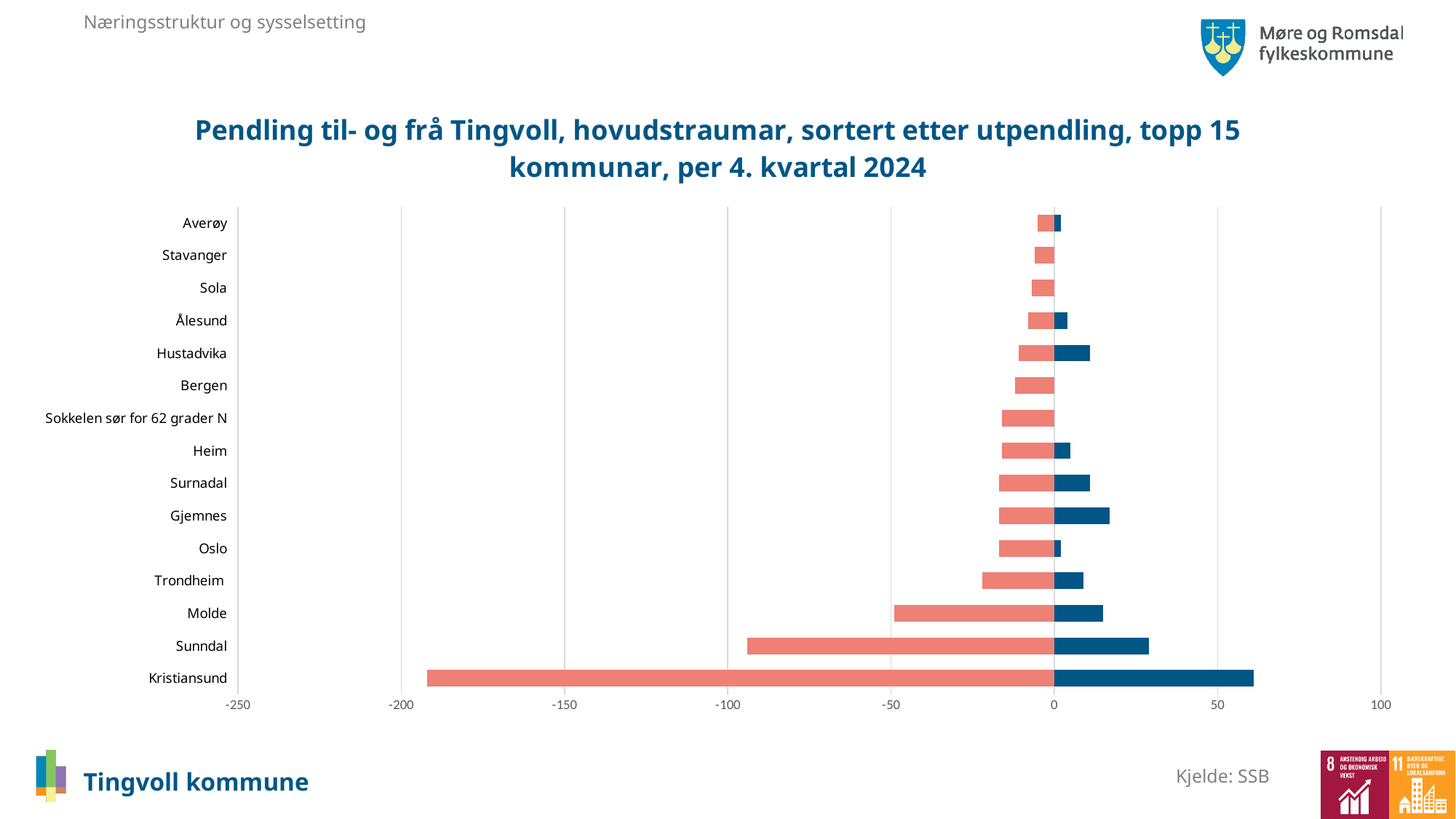
Is the red bar value for Sunndal greater or less than -50? less Is the red bar value for Kristiansund greater or less than -150? less What kind of chart is shown on the slide? bar chart What is the lowest value shown on the horizontal axis of the chart? -250 Is the blue bar value for Kristiansund greater or less than 50? greater What source is cited for the chart data on the slide? SSB Which has the longer blue bar, Gjemnes or Oslo? Gjemnes Which municipality has the longest red (negative) bar in the chart? Kristiansund Which municipality has the longest blue (positive) bar in the chart? Kristiansund How many municipalities (categories) are listed on the vertical axis of the chart? 15 Which has the longer red bar, Sunndal or Molde? Sunndal